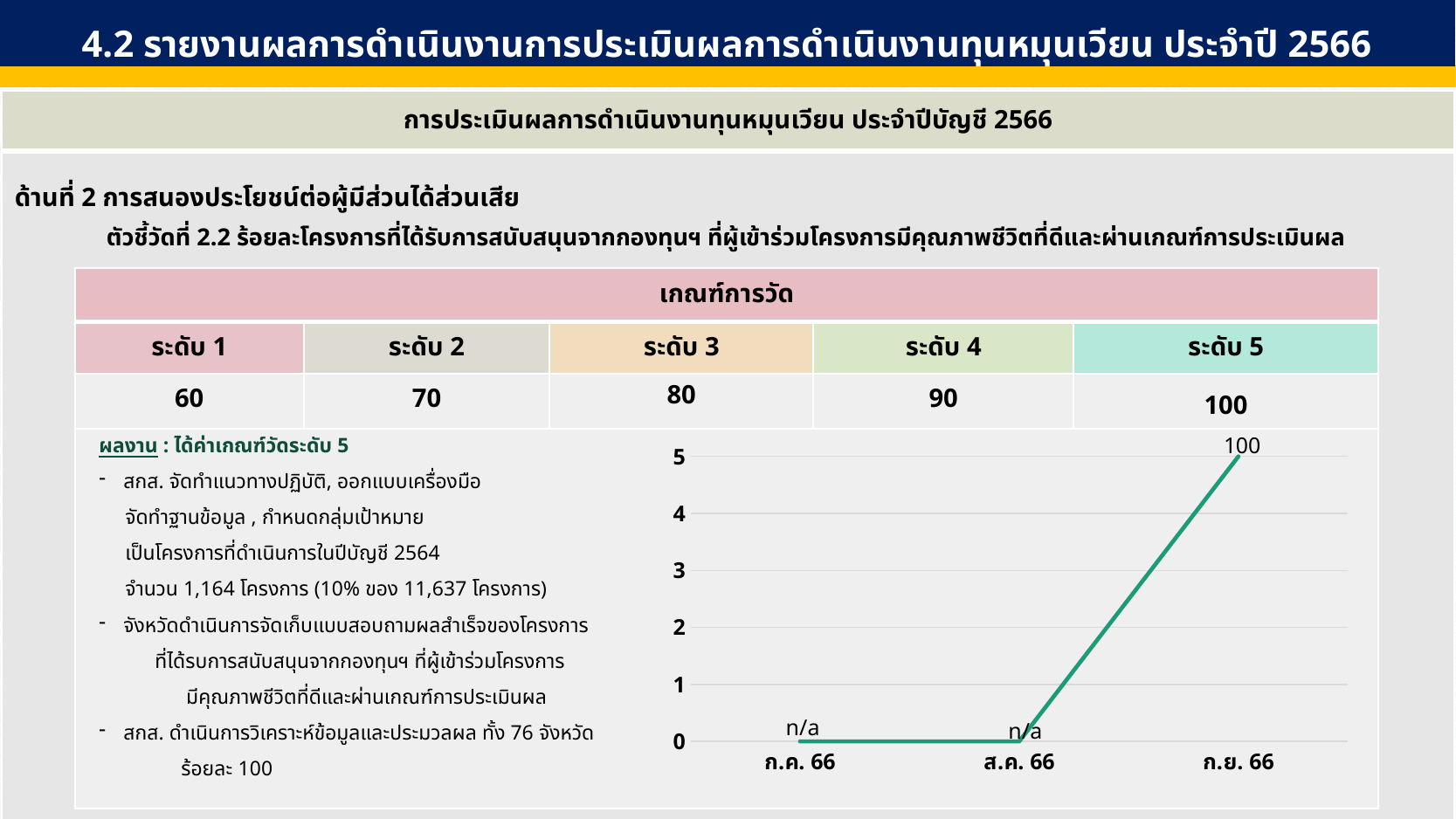
Is the point for ก.ย. 66 greater or less than 3 on the y axis? greater What data label is shown for ก.ค. 66 in the chart? n/a How many categories are shown on the x axis of the chart? 3 How many points in the chart are labelled n/a? 2 What kind of chart is shown on the slide? line chart What data label is shown for ส.ค. 66 in the chart? n/a What colour is the line in the chart? green Which category has the highest point on the line? ก.ย. 66 What data label is shown for ก.ย. 66 in the chart? 100 What is the highest tick value shown on the y axis of the chart? 5 Does the line rise or fall from ส.ค. 66 to ก.ย. 66? rise Which is higher on the line, the point for ส.ค. 66 or the point for ก.ย. 66? ก.ย. 66